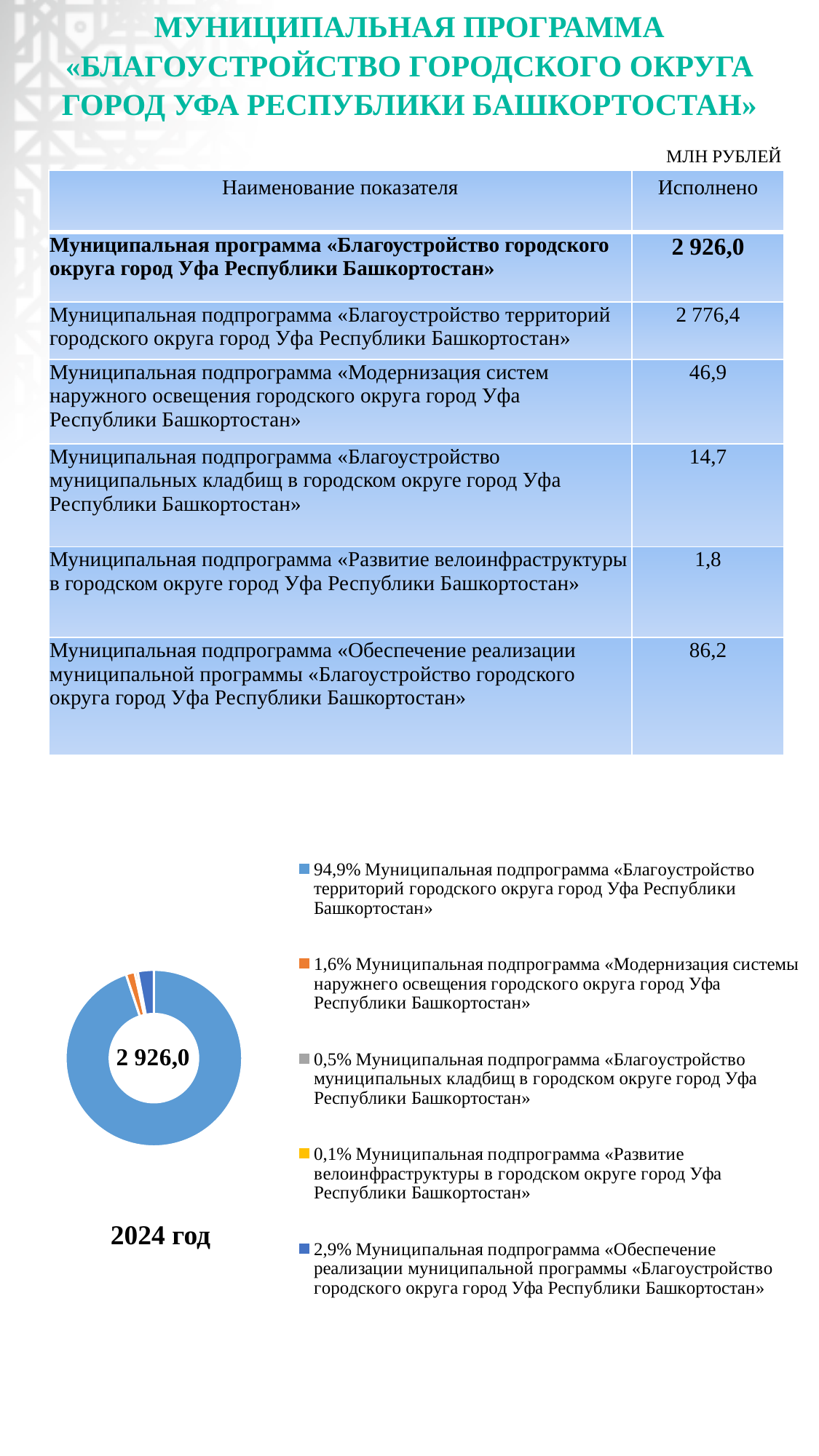
What share of the doughnut chart does the subprogram «Благоустройство муниципальных кладбищ в городском округе город Уфа Республики Башкортостан» take? 0,5% Which subprogram has the smallest slice in the doughnut chart? Муниципальная подпрограмма «Развитие велоинфраструктуры в городском округе город Уфа Республики Башкортостан» What share of the doughnut chart does the subprogram «Развитие велоинфраструктуры в городском округе город Уфа Республики Башкортостан» take? 0,1% What share of the doughnut chart does the subprogram «Обеспечение реализации муниципальной программы «Благоустройство городского округа город Уфа Республики Башкортостан» take? 2,9% What kind of chart is shown at the bottom of the slide? Doughnut (pie) chart What value is printed in the centre of the doughnut chart? 2 926,0 Which subprogram has the largest slice in the doughnut chart? Муниципальная подпрограмма «Благоустройство территорий городского округа город Уфа Республики Башкортостан» Which year is labelled under the doughnut chart? 2024 год Which slice is larger in the doughnut chart: «Модернизация системы наружнего освещения...» or «Обеспечение реализации муниципальной программы...»? «Обеспечение реализации муниципальной программы...» (2,9%) How many slices (categories) does the doughnut chart's legend list? 5